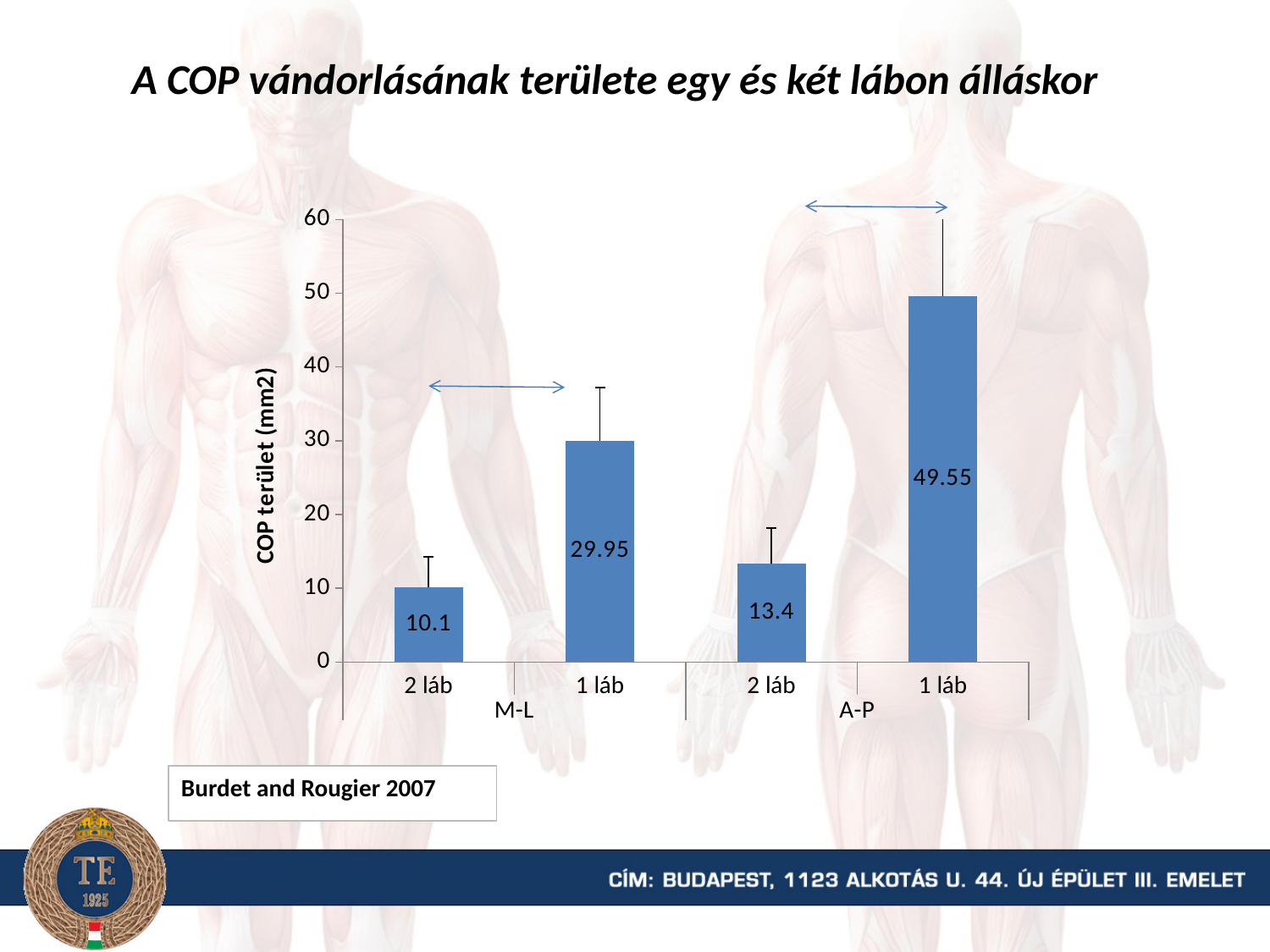
What is the difference between the 1 láb and 2 láb values in the A-P group? 36.15 What is the value for 2 láb in the A-P group? 13.4 What is the difference between the 1 láb and 2 láb values in the M-L group? 19.85 What is the value for 2 láb in the M-L group? 10.1 What is the label of the vertical axis? COP terület (mm2) Which bar has the lowest value? 2 láb (M-L) What is the value for 1 láb in the M-L group? 29.95 Which is larger: the 2 láb value in the M-L group or the 2 láb value in the A-P group? 2 láb in the A-P group What kind of chart is shown on the slide? Bar chart How many bars are plotted in the chart? 4 Which bar has the highest value? 1 láb (A-P) What is the value for 1 láb in the A-P group? 49.55